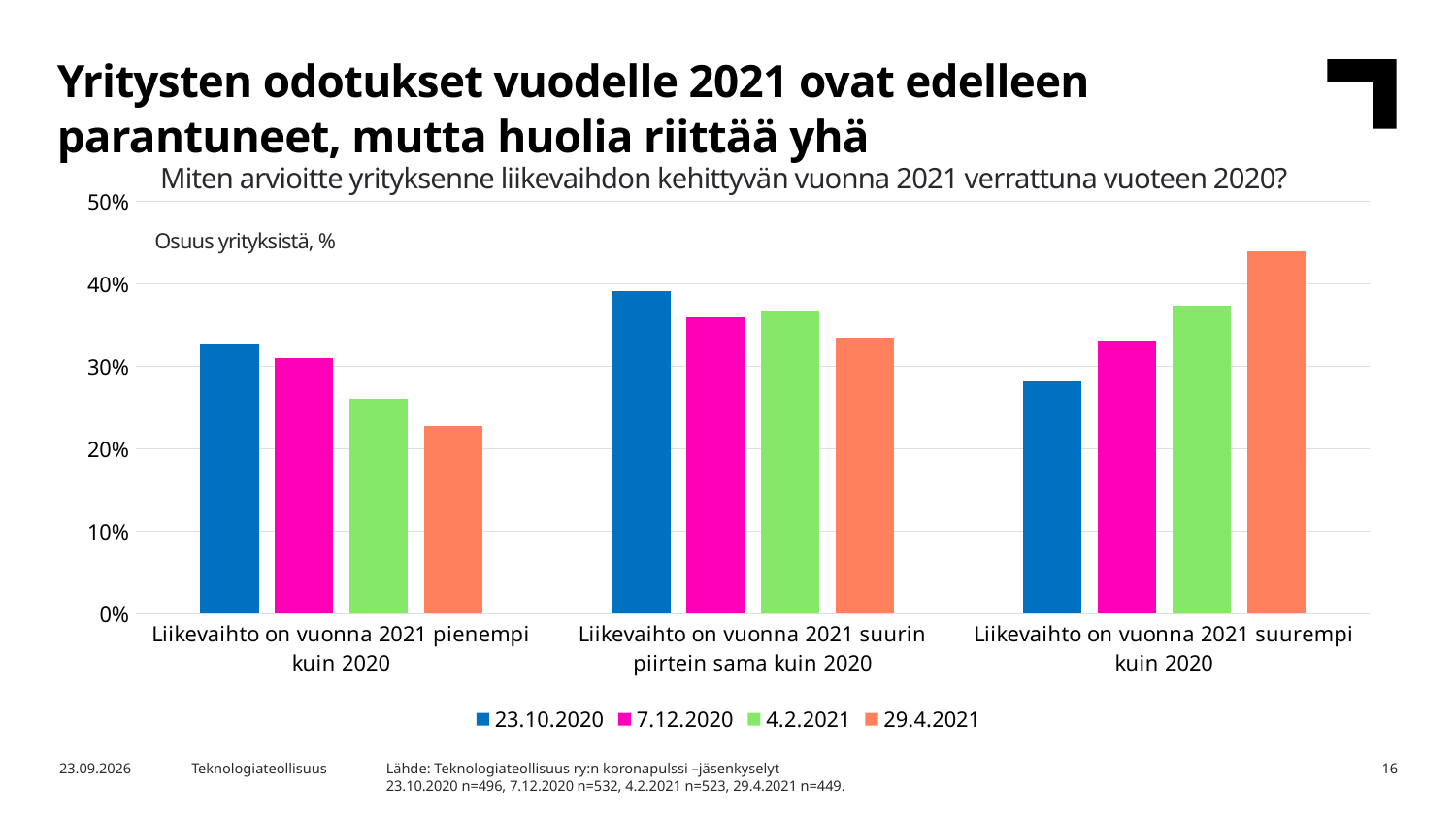
How many categories are shown on the x axis of the chart? 3 In the category "Liikevaihto on vuonna 2021 pienempi kuin 2020", do the values rise or fall from 23.10.2020 to 29.4.2021? fall What kind of chart is shown on the slide? bar chart In the category "Liikevaihto on vuonna 2021 suurempi kuin 2020", which survey date has the highest value? 29.4.2021 What is the first entry in the chart legend? 23.10.2020 In the category "Liikevaihto on vuonna 2021 pienempi kuin 2020", which survey date has the lowest value? 29.4.2021 How many series does the chart legend list? 4 Is the value for 29.4.2021 in the category "Liikevaihto on vuonna 2021 suurempi kuin 2020" greater or less than 40%? greater Is the value for 29.4.2021 in the category "Liikevaihto on vuonna 2021 pienempi kuin 2020" greater or less than 30%? less Is the value for 7.12.2020 in the category "Liikevaihto on vuonna 2021 suurin piirtein sama kuin 2020" greater or less than 30%? greater In the category "Liikevaihto on vuonna 2021 suurempi kuin 2020", which is larger: the value for 23.10.2020 or for 29.4.2021? 29.4.2021